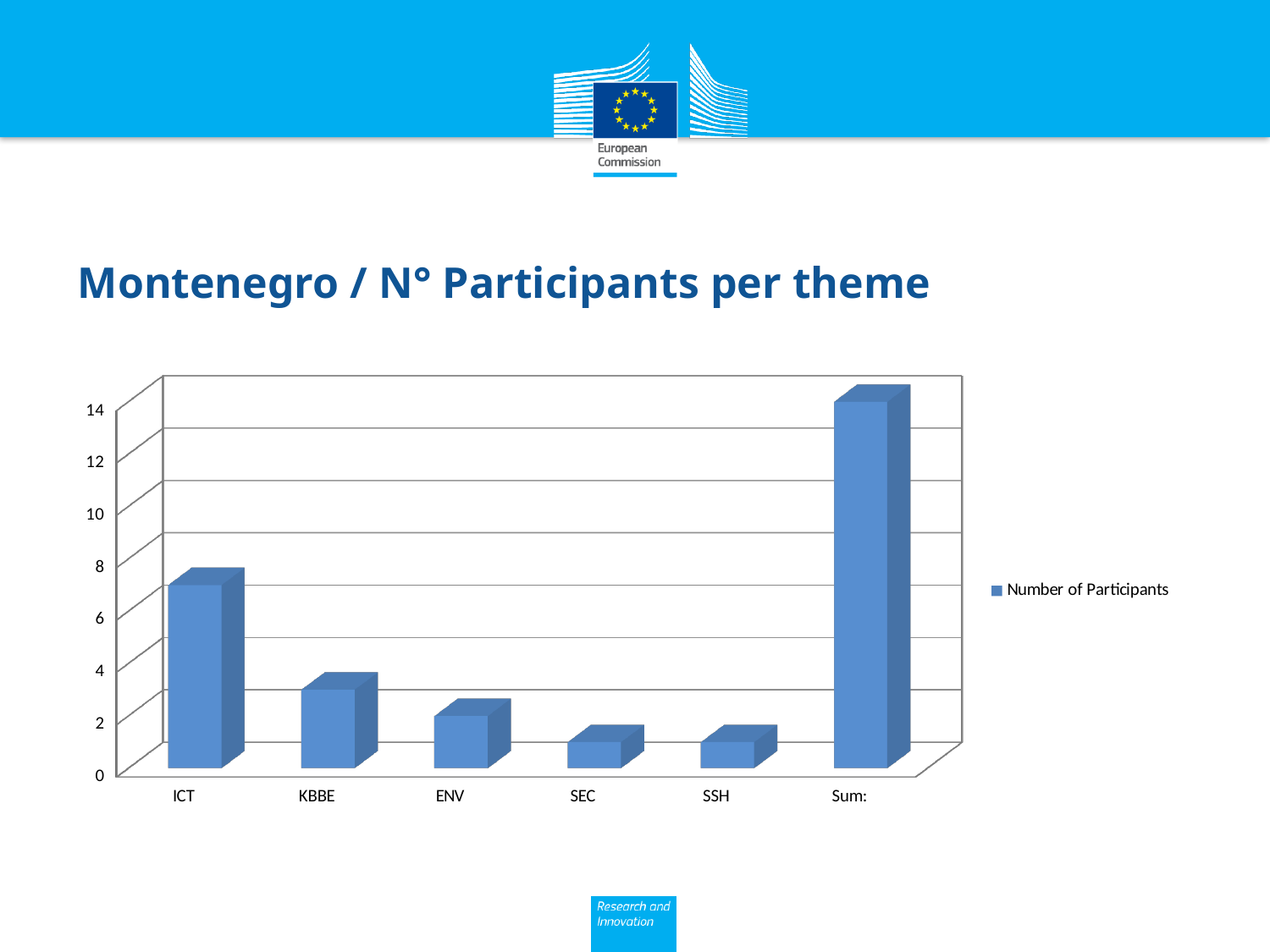
What is the title of the chart on the slide? Montenegro / N° Participants per theme How many series does the chart's legend list? 1 Is the value for KBBE greater or less than 4? less Which is larger, the value for ICT or the value for KBBE? ICT What kind of chart is shown on the slide? bar chart Is the value for SEC greater or less than 2? less How many categories are shown on the x axis of the chart? 6 Is the value for ICT greater or less than 6? greater What series name is shown in the chart's legend? Number of Participants Which category has the highest bar in the chart? Sum: Which is larger, the value for ENV or the value for SSH? ENV